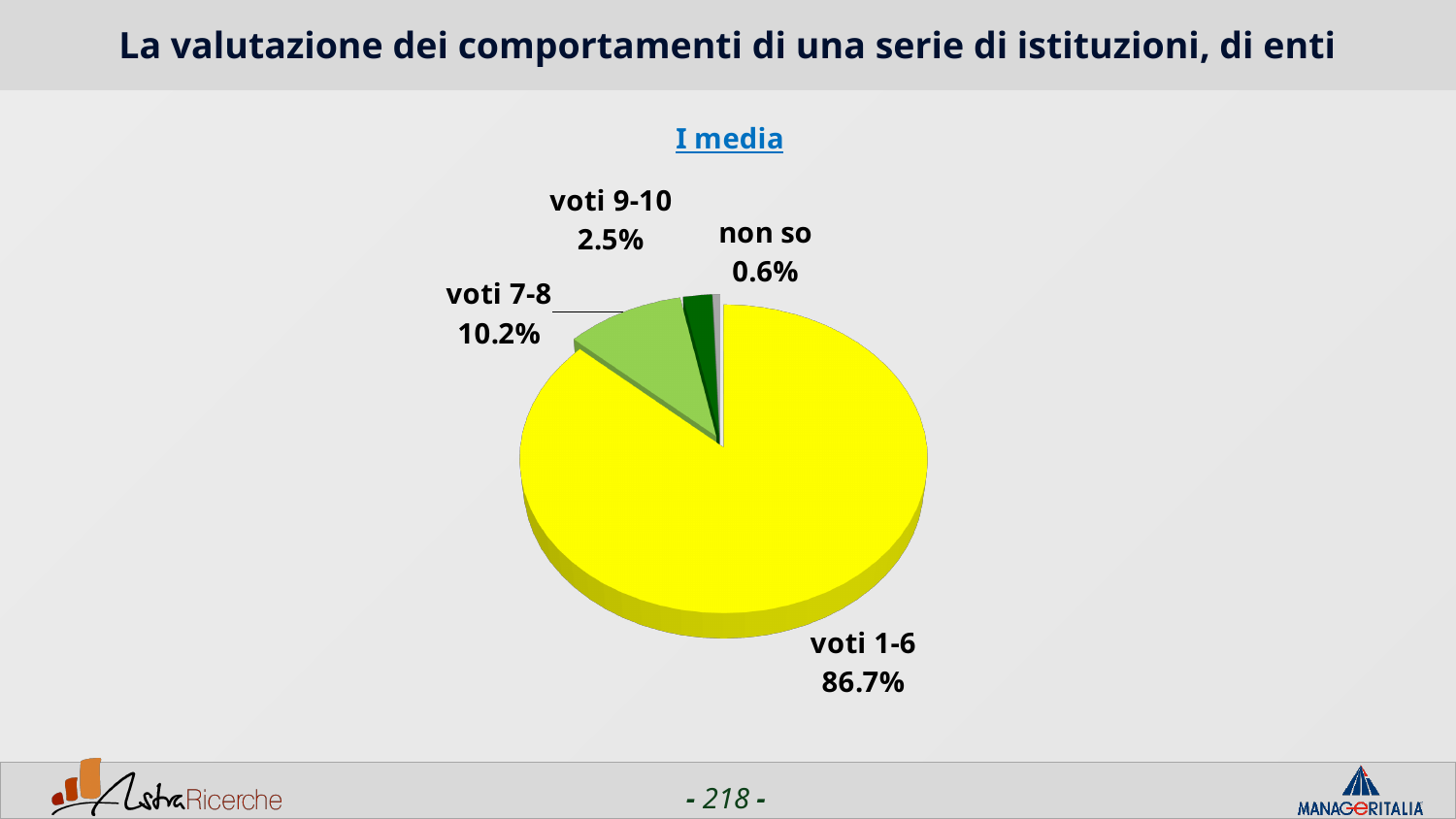
What colour is the 'voti 1-6' slice? yellow What is the difference between 'voti 1-6' and 'voti 7-8'? 76.5% What is the title of the chart? I media Which category has the smallest slice? non so Which is larger, 'voti 7-8' or 'voti 9-10'? voti 7-8 What is the value for 'voti 9-10'? 2.5% Which category has the largest slice? voti 1-6 How many slices does the pie chart have? 4 What is the value for 'voti 1-6'? 86.7% What kind of chart is shown on the slide? pie chart What is the value for 'voti 7-8'? 10.2% What is the value for 'non so'? 0.6%